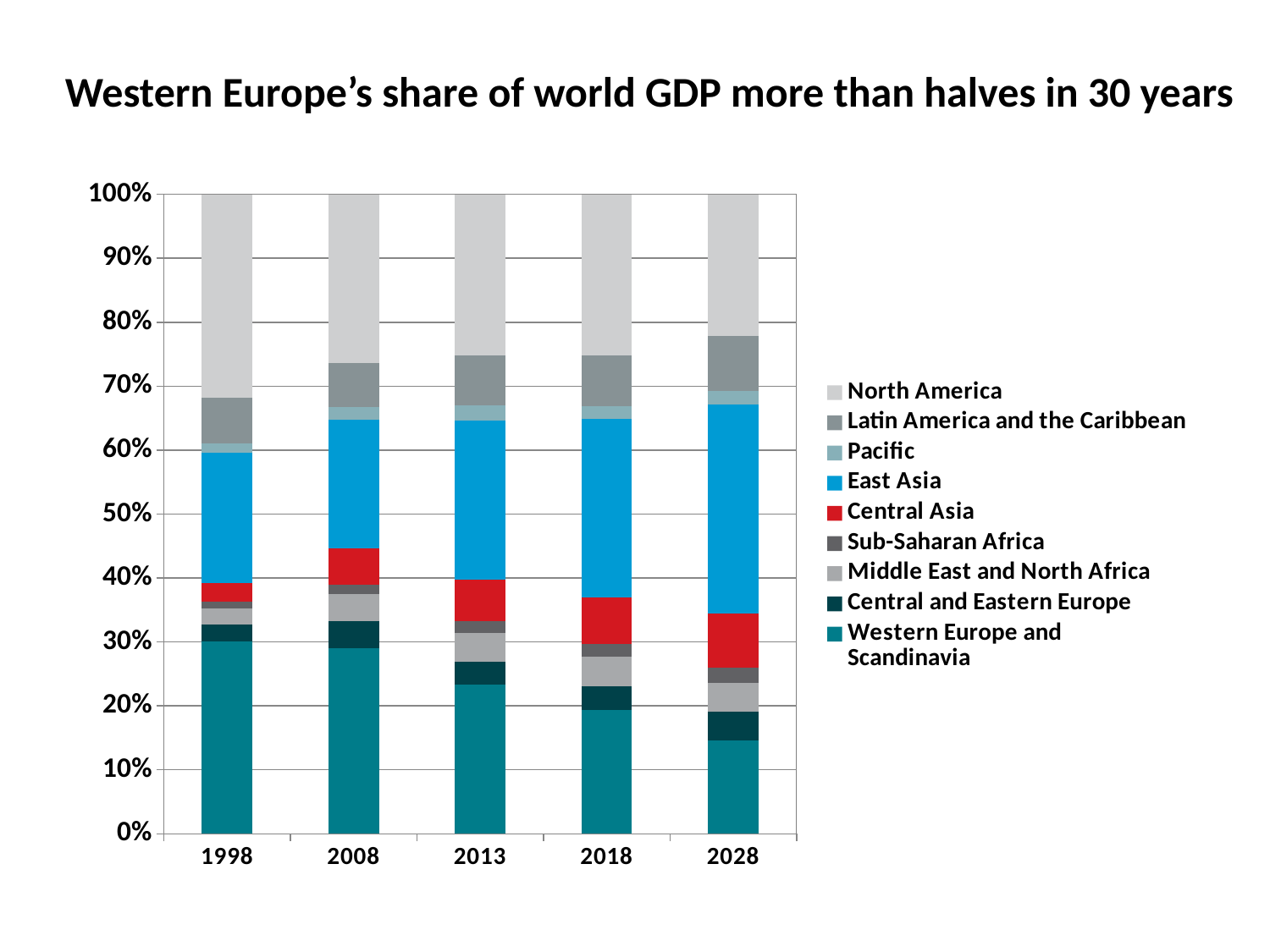
Is the East Asia share larger in 1998 or in 2028? 2028 What is the total of the stacked bar for 2013? 100% What kind of chart is shown on the slide? Stacked bar chart What is the title of the slide? Western Europe's share of world GDP more than halves in 30 years How many years are shown along the x axis? 5 How many series does the legend list? 9 Is the Western Europe and Scandinavia share in 2018 greater or less than 10%? greater Is the Western Europe and Scandinavia share in 2028 greater or less than 20%? less Does the Western Europe and Scandinavia share rise or fall from 1998 to 2028? Fall In which year is the Western Europe and Scandinavia share lowest? 2028 Which series is listed first in the legend? North America Is the Western Europe and Scandinavia share in 1998 greater or less than 20%? greater